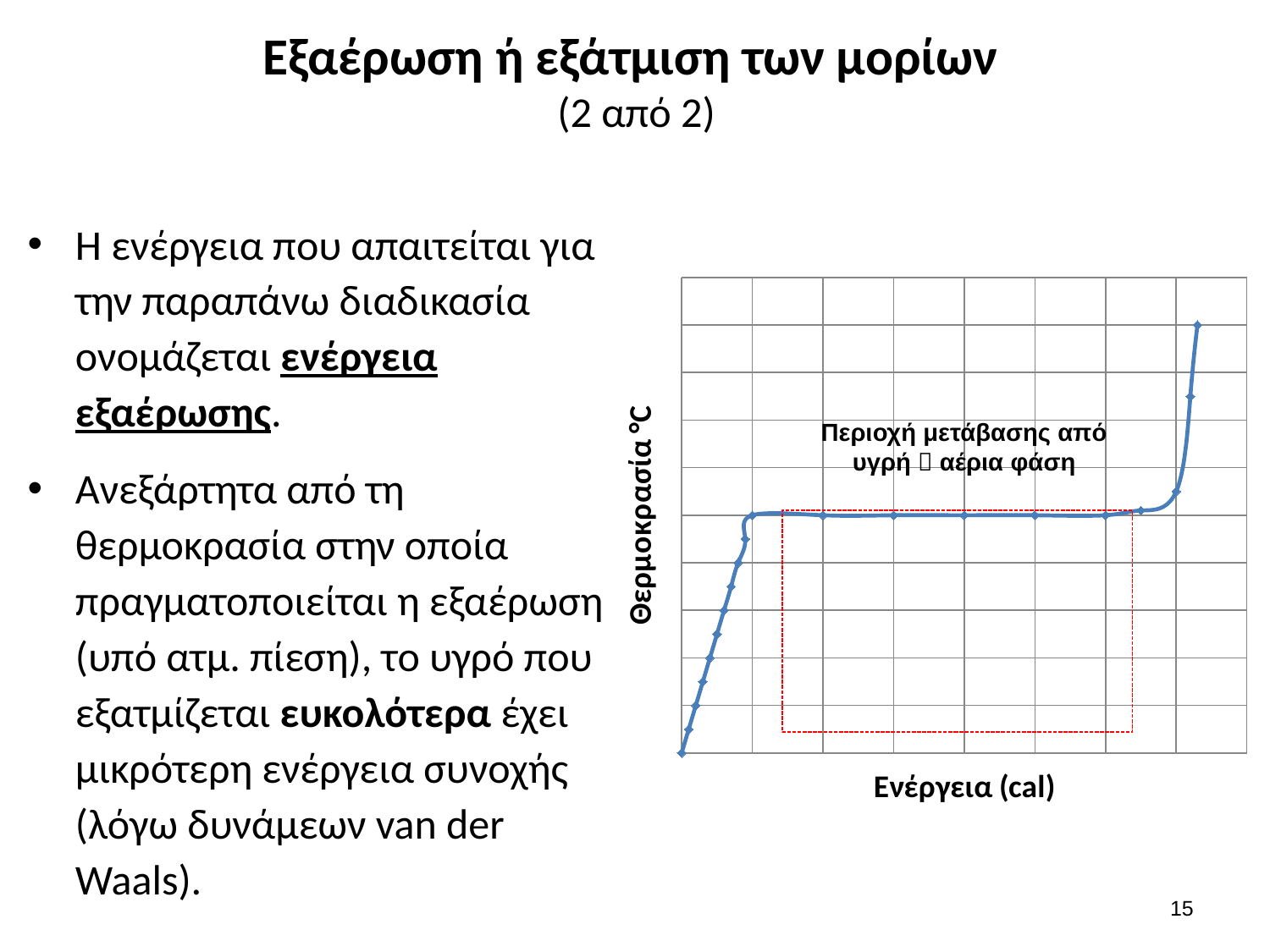
Overall, does the plotted temperature rise or fall as energy increases along the x axis? rises In the region marked as the transition from liquid to gas phase, does the temperature rise, fall, or stay flat as energy increases? stays flat What is the label of the y axis of the chart? Θερμοκρασία °C What kind of chart is shown on the slide? line chart What is the label of the x axis of the chart? Ενέργεια (cal) At the far right end of the curve, does the temperature rise or fall as energy increases? rises